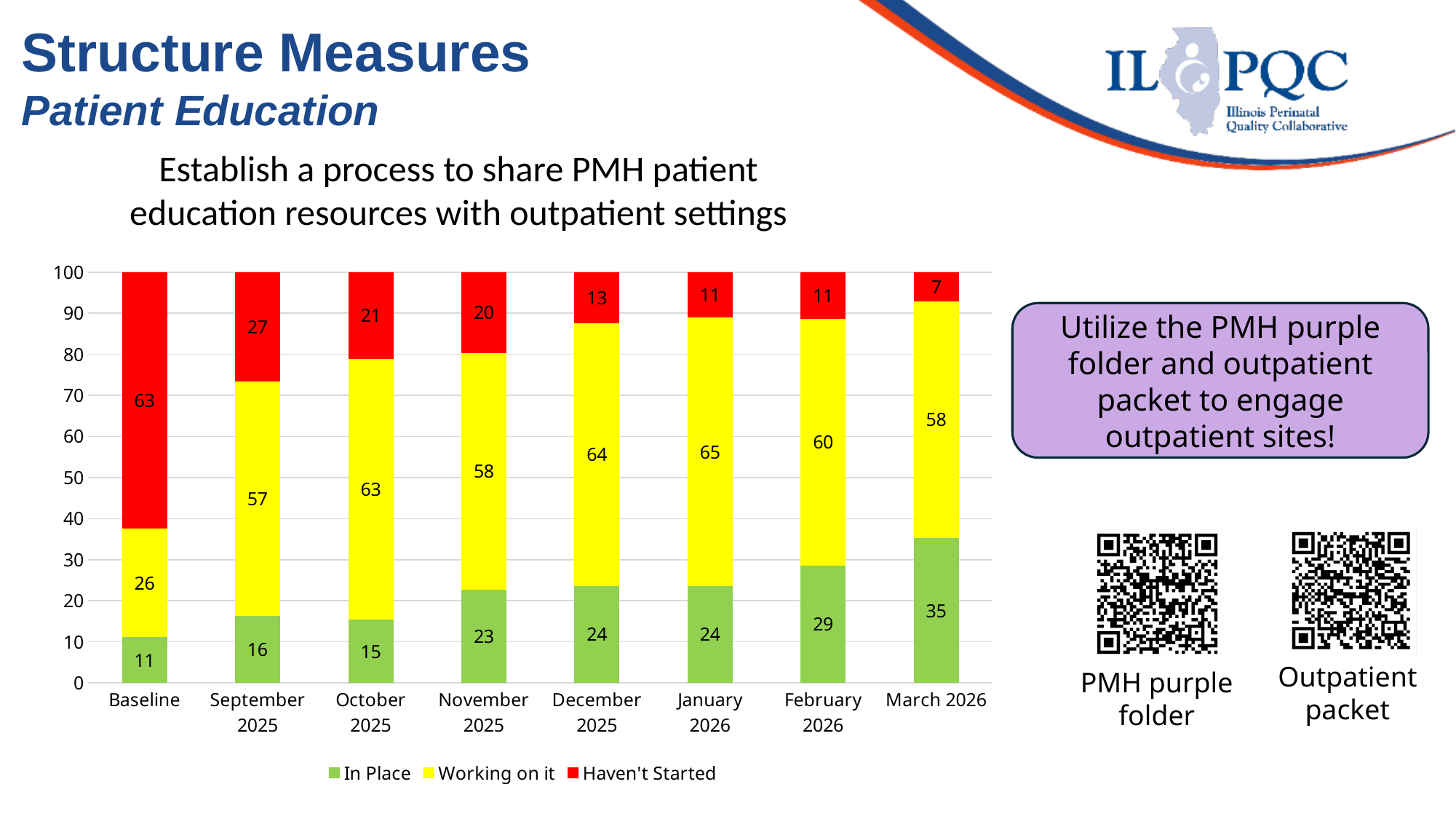
What is the value for Working on it in January 2026? 65 What is the difference between the In Place values for March 2026 and Baseline? 24 What is the value for Haven't Started at Baseline? 63 How many series does the legend list? 3 Which colour represents the Haven't Started series? Red What is the value for In Place in March 2026? 35 Which is larger, the Working on it value for October 2025 or for November 2025? October 2025 How many categories are shown on the x axis? 8 Which category has the highest In Place value? March 2026 Which category has the lowest Haven't Started value? March 2026 What kind of chart is shown on the slide? Stacked bar chart Does the In Place value rise or fall from Baseline to March 2026? Rise